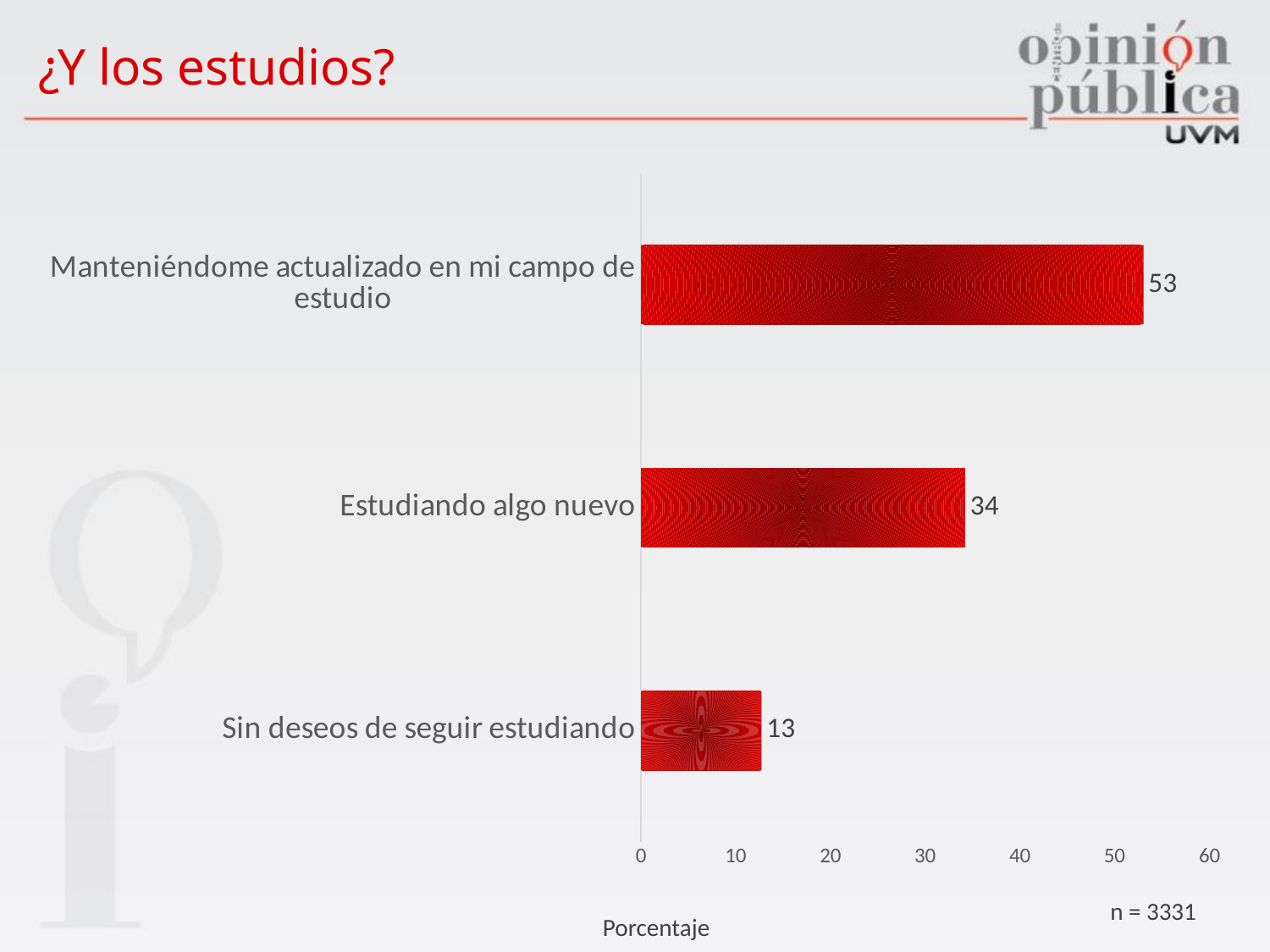
What is the difference between the values for "Manteniéndome actualizado en mi campo de estudio" and "Estudiando algo nuevo"? 19 What is the value for "Manteniéndome actualizado en mi campo de estudio"? 53 What is the difference between the values for "Estudiando algo nuevo" and "Sin deseos de seguir estudiando"? 21 Which category has the highest value? Manteniéndome actualizado en mi campo de estudio What is the value for "Sin deseos de seguir estudiando"? 13 How many categories are shown in the chart? 3 Which category has the lowest value? Sin deseos de seguir estudiando What kind of chart is shown on the slide? Bar chart Is the value for "Estudiando algo nuevo" greater or less than 30? greater What is the value for "Estudiando algo nuevo"? 34 Which is larger, the value for "Estudiando algo nuevo" or for "Sin deseos de seguir estudiando"? Estudiando algo nuevo What is the label of the horizontal axis? Porcentaje